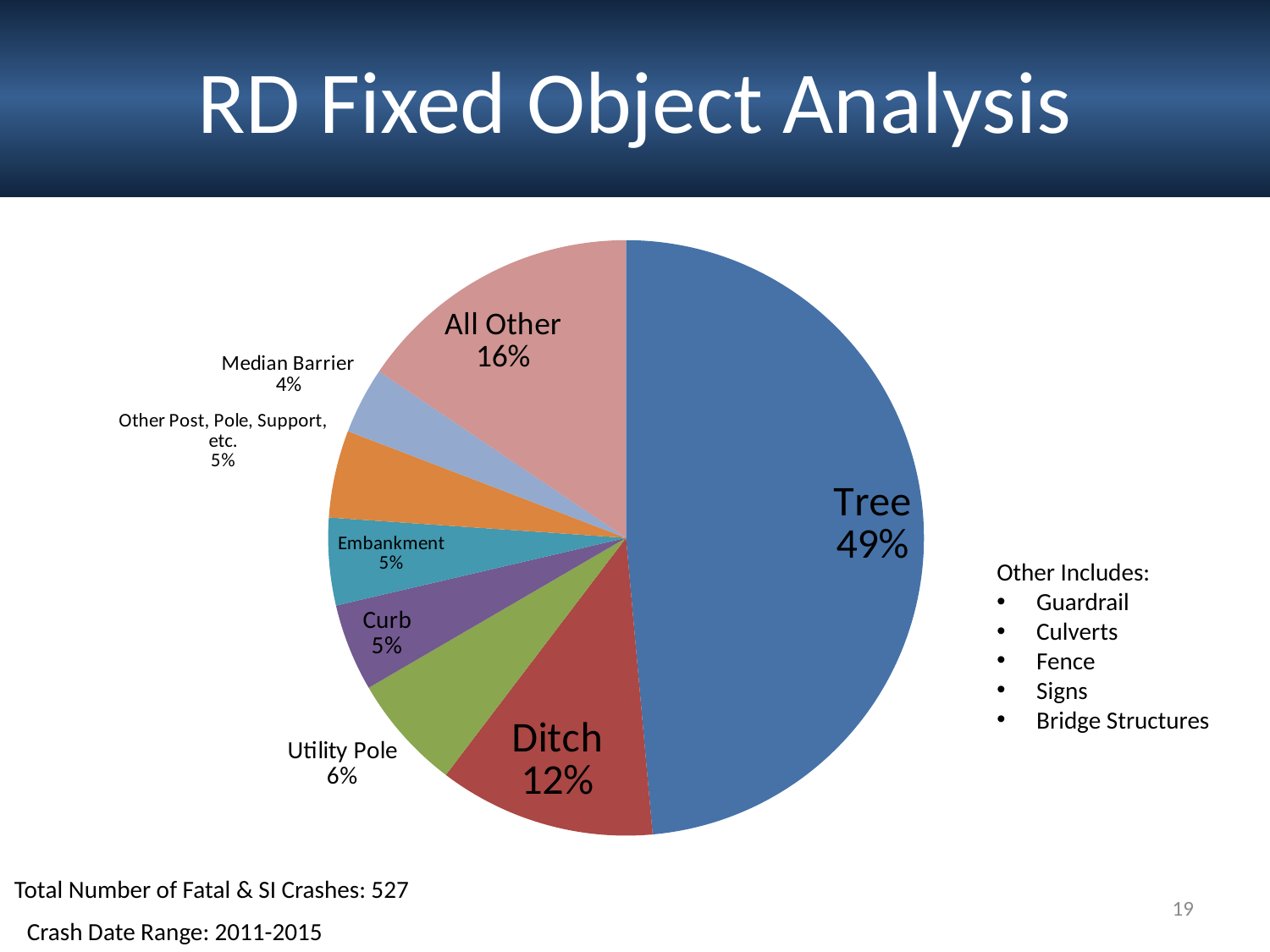
What is the value shown for Median Barrier? 4% What is the difference in percentage points between Tree and Ditch? 37 Which category has the smallest slice of the pie? Median Barrier What is the title of the slide containing the pie chart? RD Fixed Object Analysis What is the value shown for Utility Pole? 6% Which category has the largest slice of the pie? Tree What is the value shown for All Other? 16% How many slices does the pie chart have? 8 What share of the pie does Tree account for? 49% What kind of chart is shown on the slide? Pie chart What is the value shown for Ditch? 12% Which is larger, the slice for All Other or the slice for Ditch? All Other